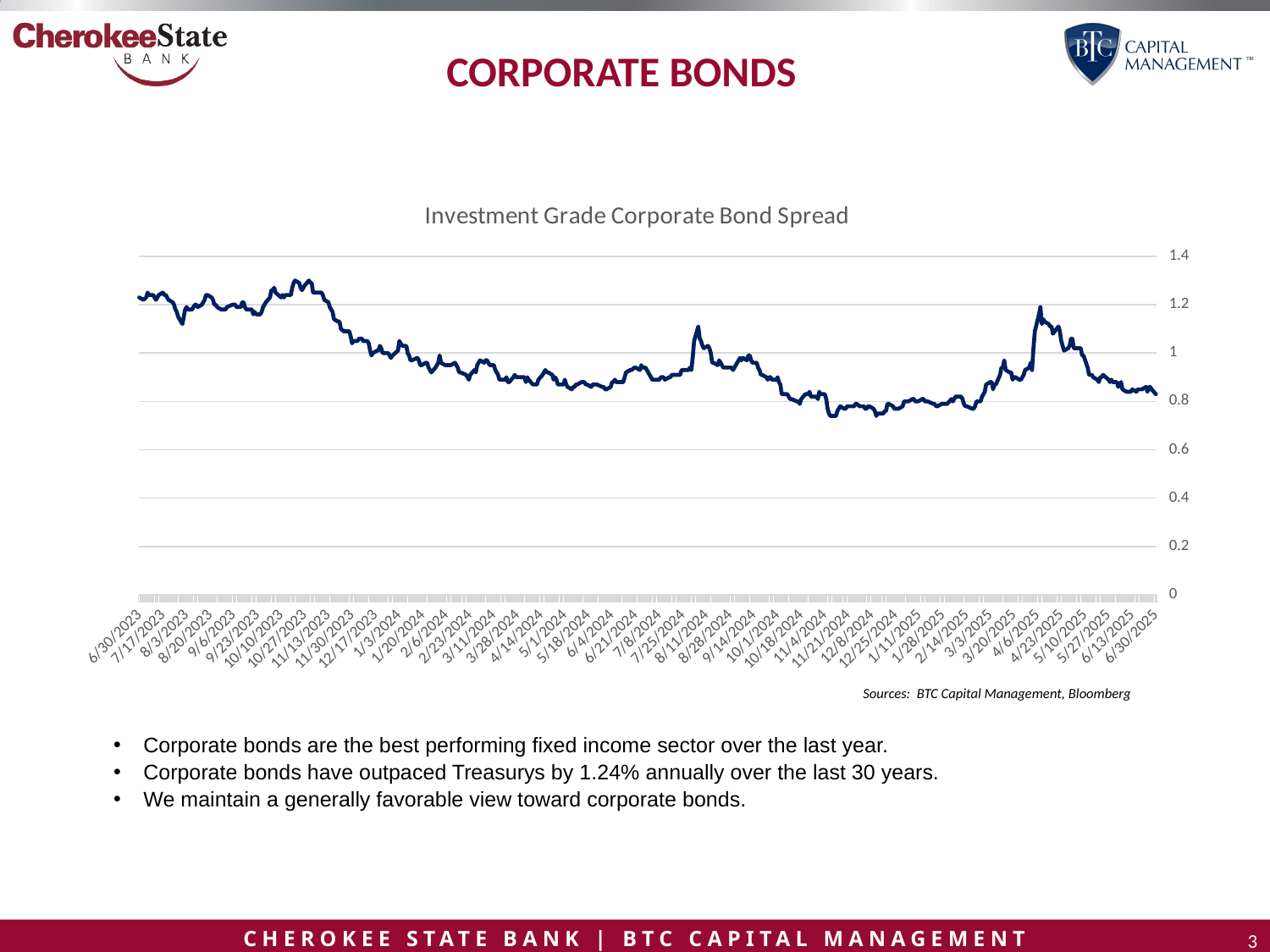
Overall, does the spread rise or fall from 6/30/2023 to 6/30/2025? fall What is the highest value shown on the vertical axis? 1.4 How many lines (series) are plotted on the chart? 1 What kind of chart is shown on the slide? line chart Which is larger, the value at 11/13/2023 or the value at 12/8/2024? 11/13/2023 What is the title of the chart? Investment Grade Corporate Bond Spread Is the value at 6/30/2025 greater or less than 1? less What sources are cited below the chart? BTC Capital Management, Bloomberg Which is larger, the value at 6/30/2023 or the value at 6/30/2025? 6/30/2023 Is the value at 6/30/2023 greater or less than 1? greater